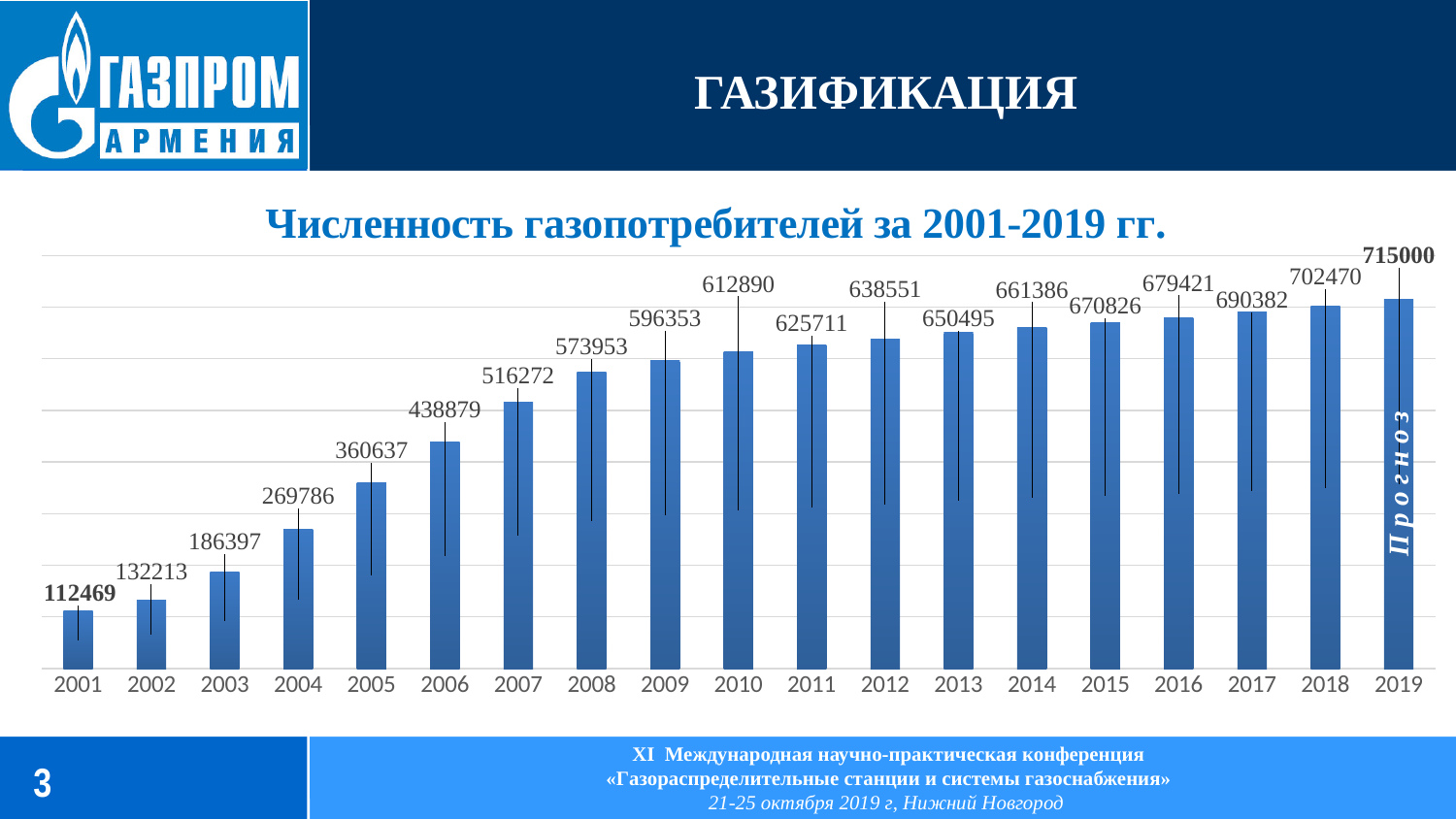
What value is shown for 2005? 360637 Which year has the lowest number of gas consumers? 2001 What is the number of gas consumers shown for 2010? 612890 What is the difference between the values for 2018 and 2017? 12088 How many years are shown on the x axis? 19 Do the values rise or fall from 2001 to 2019? Rise What is the title of the chart? Численность газопотребителей за 2001-2019 гг. What is the difference between the values for 2002 and 2001? 19744 Which is larger, the value for 2008 or the value for 2007? 2008 What kind of chart is shown on the slide? Bar chart Which year has the highest value on the chart? 2019 What is the forecast value shown for 2019? 715000